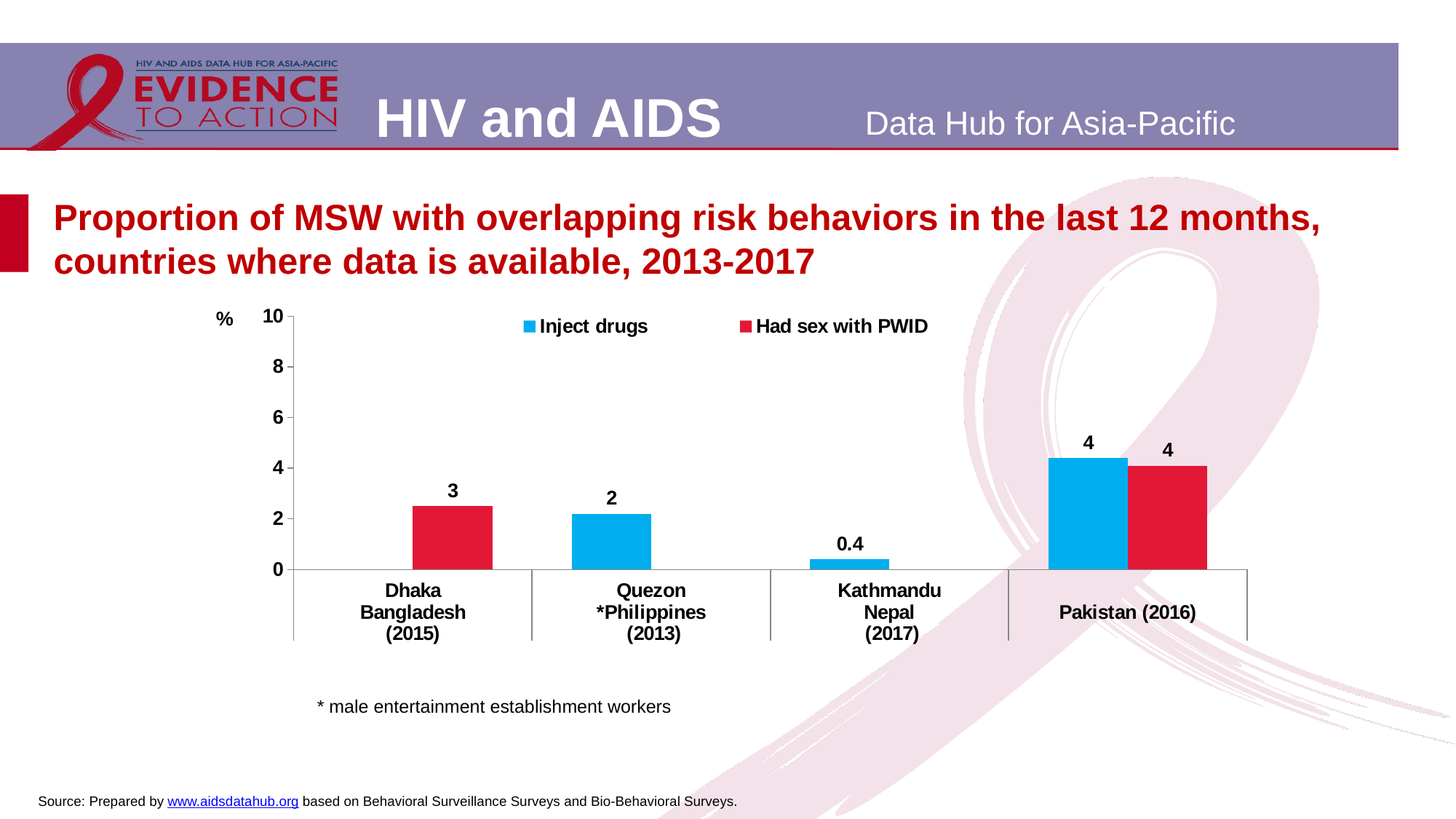
Which is larger: the Had sex with PWID value for Dhaka, Bangladesh (2015) or the Inject drugs value for Quezon, Philippines (2013)? Dhaka, Bangladesh (2015) Is the Had sex with PWID value for Dhaka, Bangladesh (2015) greater or less than 2? greater What kind of chart is shown on the slide? Bar chart How many series does the chart legend list? 2 What is the value for Inject drugs in Pakistan (2016)? 4 What is the value for Had sex with PWID in Dhaka, Bangladesh (2015)? 3 What is the value for Inject drugs in Kathmandu, Nepal (2017)? 0.4 What is the difference between the Inject drugs values for Pakistan (2016) and Quezon, Philippines (2013)? 2 What is the value for Inject drugs in Quezon, Philippines (2013)? 2 Which location has the highest value for Inject drugs? Pakistan (2016) How many locations are shown on the x axis of the chart? 4